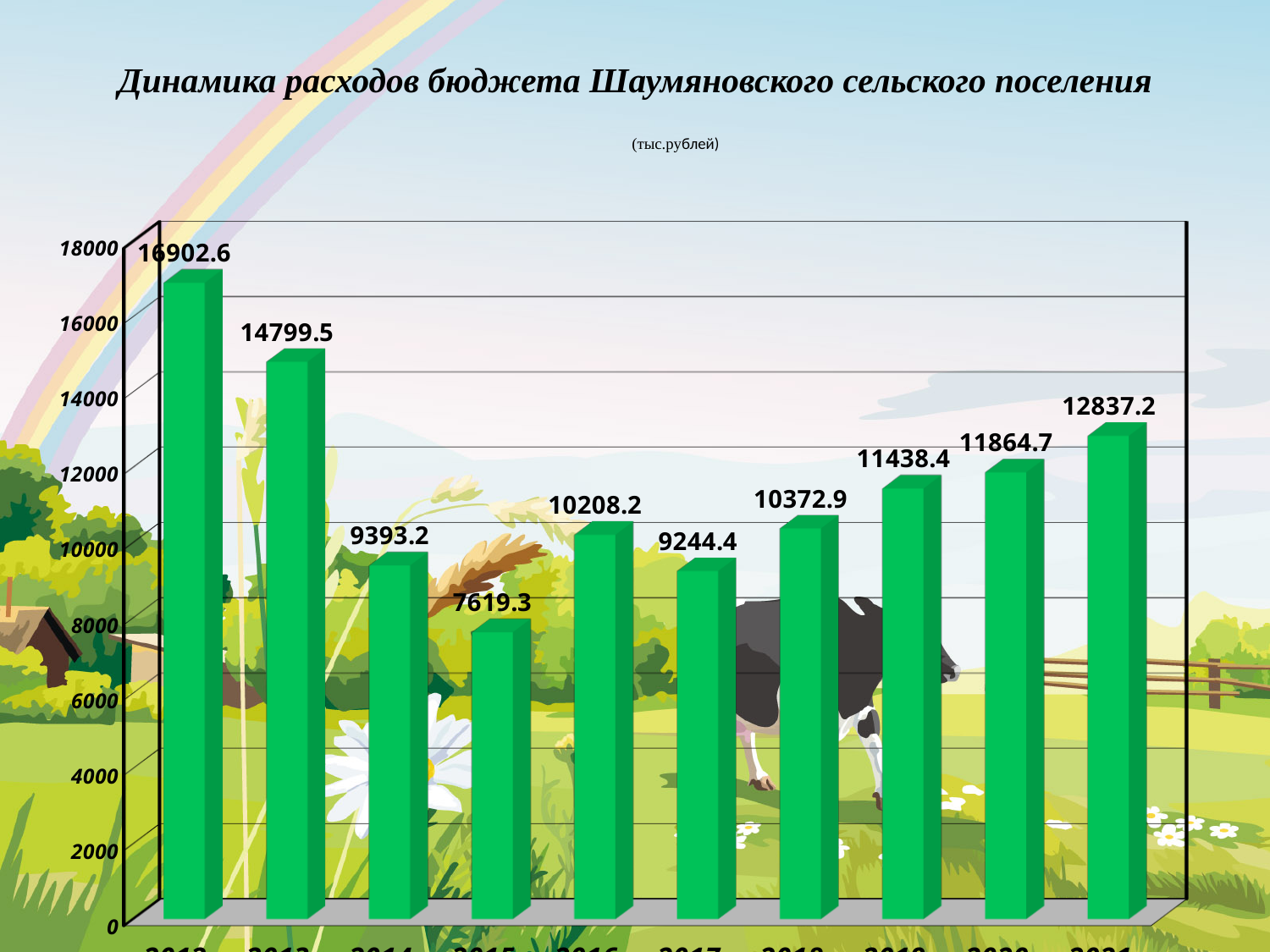
Which bar has the highest value? the first (leftmost) bar, 16902.6 What is the value of the first (leftmost) bar? 16902.6 What is the difference between the first bar (16902.6) and the second bar (14799.5)? 2103.1 Which bar has the lowest value? the fourth bar, 7619.3 Do the values rise or fall across the last four bars on the right? rise What is the value of the seventh bar from the left? 10372.9 What is the value of the last (rightmost) bar? 12837.2 What unit is stated under the chart title? тыс.рублей What kind of chart is shown on the slide? bar chart What is the value of the fourth bar from the left? 7619.3 Which is larger: the fifth bar or the sixth bar? the fifth bar (10208.2) How many bars are plotted in the chart? 10